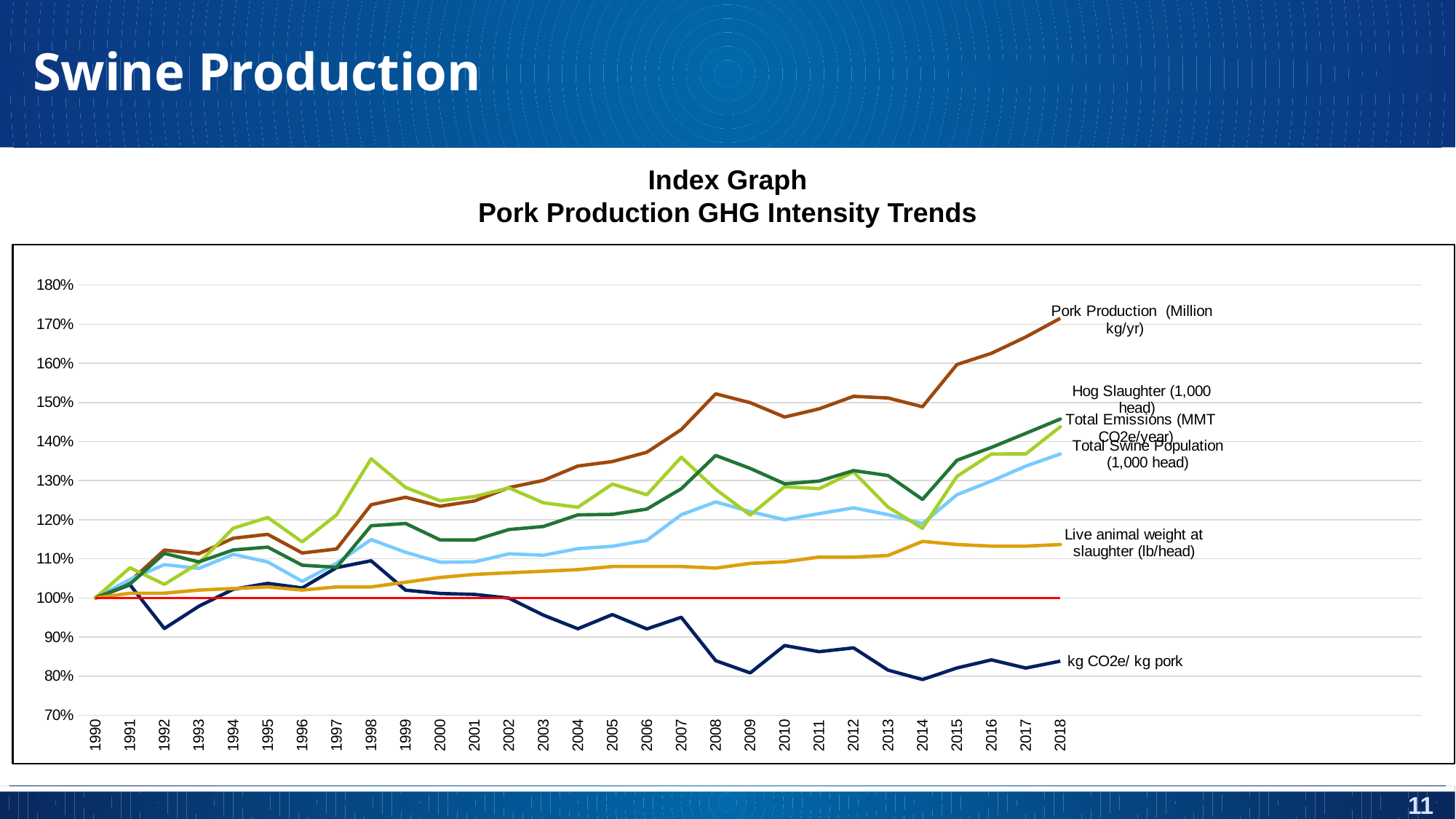
How many years are plotted along the x axis? 29 What is the title of the chart? Index Graph Pork Production GHG Intensity Trends Does the kg CO2e/ kg pork series generally rise or fall from 1990 to 2018? fall Is the value for Live animal weight at slaughter (lb/head) in 2018 greater or less than 110%? greater Is the value for kg CO2e/ kg pork in 2014 greater or less than 90%? less Which series has the lowest value in 2018? kg CO2e/ kg pork Which series has the highest value in 2018? Pork Production (Million kg/yr) In 2018, which is larger: Hog Slaughter (1,000 head) or Total Swine Population (1,000 head)? Hog Slaughter (1,000 head) Is the value for Pork Production (Million kg/yr) in 2018 greater or less than 160%? greater What is the first year and the last year shown on the x axis? 1990 and 2018 What kind of chart is shown on the slide? line chart What value do all the series share in 1990? 100%